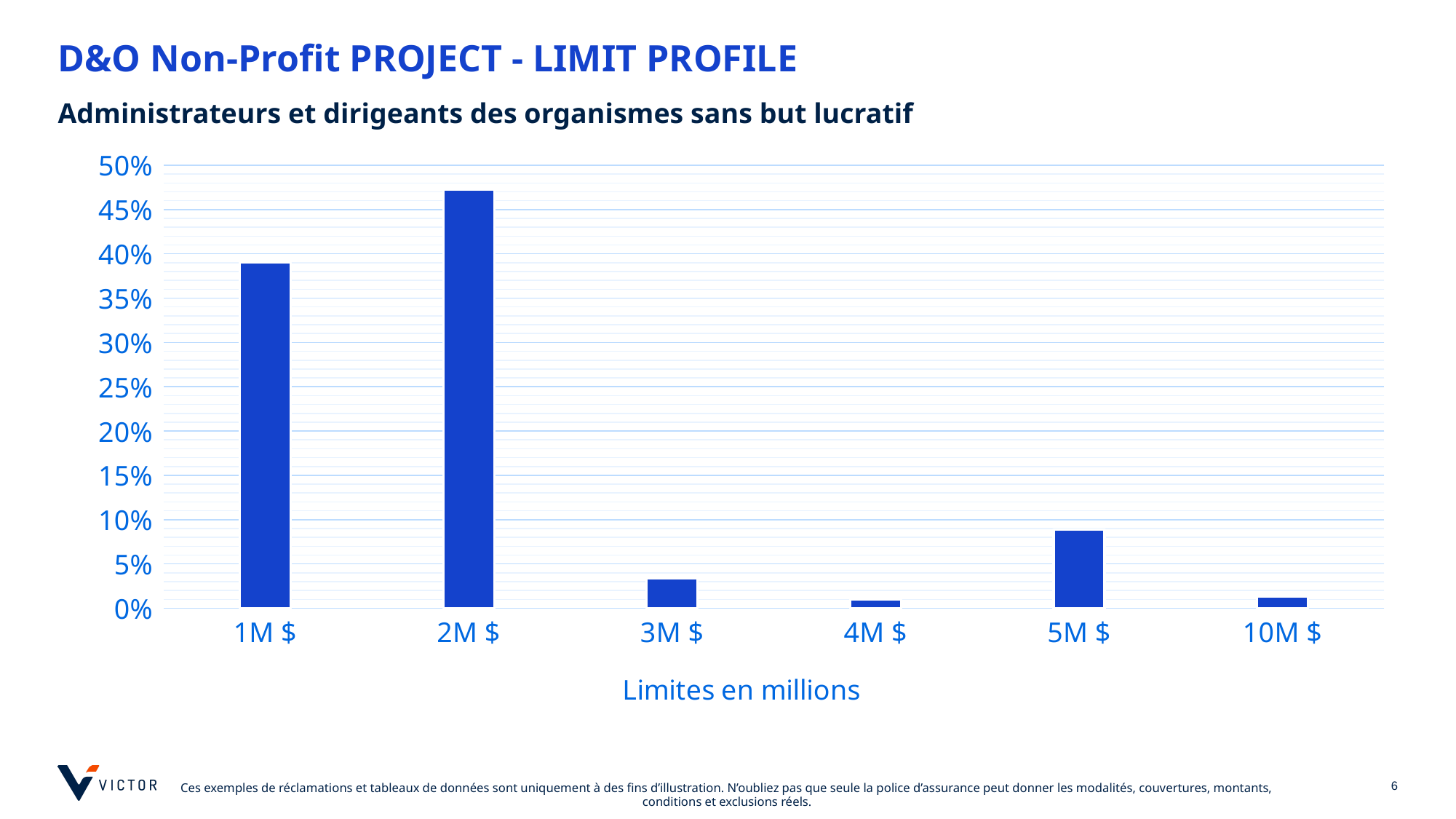
Is the value for 2M $ greater or less than 45%? greater How many limit categories are shown on the x axis? 6 Is the value for 1M $ greater or less than 35%? greater What kind of chart is shown on the slide? bar chart Is the value for 2M $ greater or less than 50%? less Which is larger, the value for 1M $ or the value for 2M $? 2M $ What is the title of the x axis? Limites en millions Which is larger, the value for 3M $ or the value for 5M $? 5M $ Does the value rise or fall from 2M $ to 3M $? fall Which limit category has the highest value? 2M $